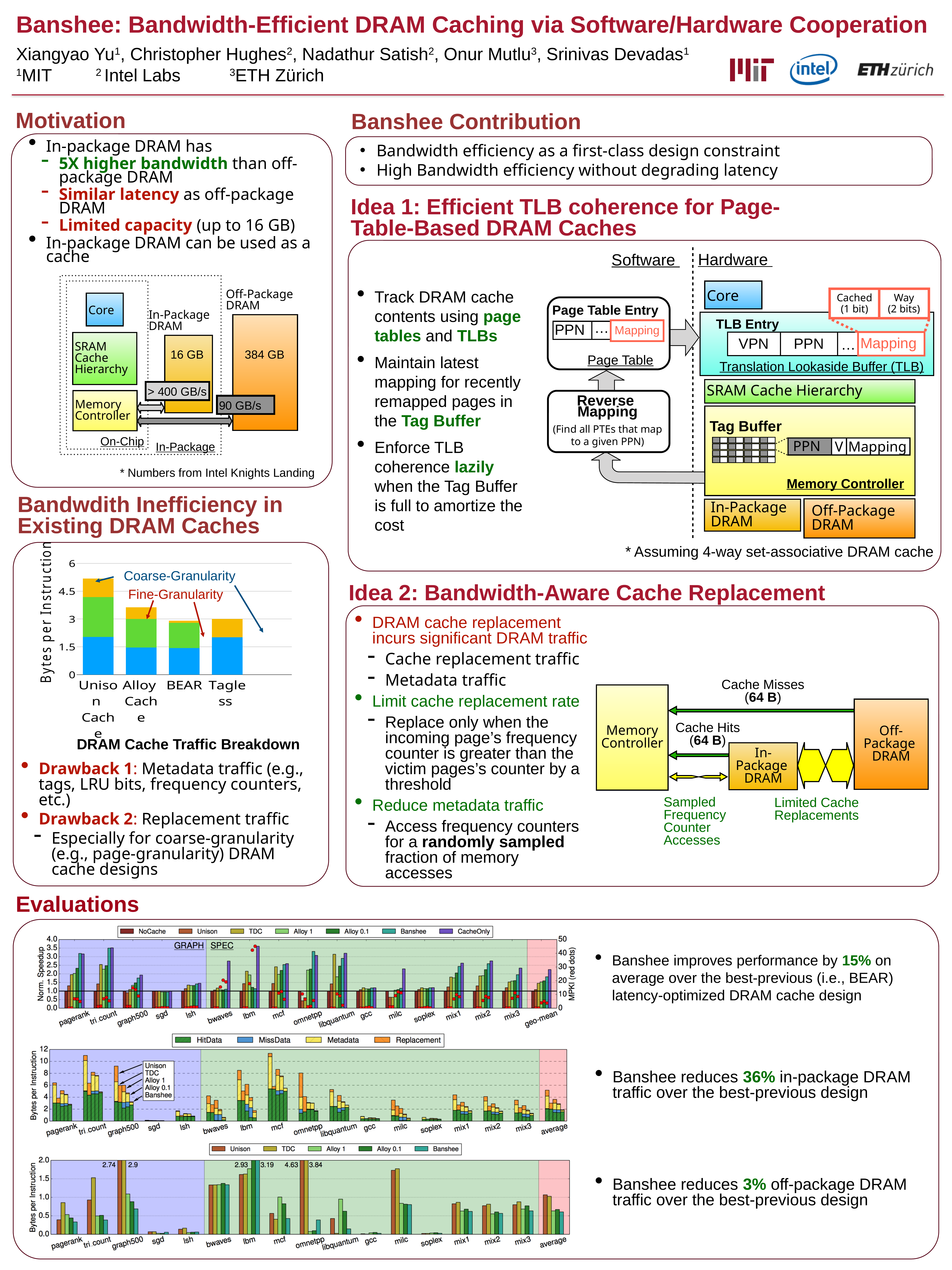
What is the y-axis label of the "DRAM Cache Traffic Breakdown" chart? Bytes per Instruction How many series does the legend list in the middle Evaluations chart (HitData, MissData, ...)? 4 How many series does the legend list in the bottom Evaluations chart? 5 How many categories are shown on the x axis of the "DRAM Cache Traffic Breakdown" chart? 4 In the "DRAM Cache Traffic Breakdown" chart, is the total for Alloy Cache greater or less than 3? greater In the "DRAM Cache Traffic Breakdown" chart, is the total for Unison Cache greater or less than 4.5? greater How many benchmark categories are shown on the x axis of the top Evaluations chart (Norm. Speedup)? 17 What kind of chart is the "DRAM Cache Traffic Breakdown" chart? Stacked bar chart How many series does the legend list in the top Evaluations chart (Norm. Speedup)? 7 In the bottom Evaluations chart, what is the largest value printed as a data label above a clipped bar? 4.63 In the "DRAM Cache Traffic Breakdown" chart, which has a larger total: Unison Cache or Tagless? Unison Cache In the "DRAM Cache Traffic Breakdown" chart, which category has the highest total bytes per instruction? Unison Cache